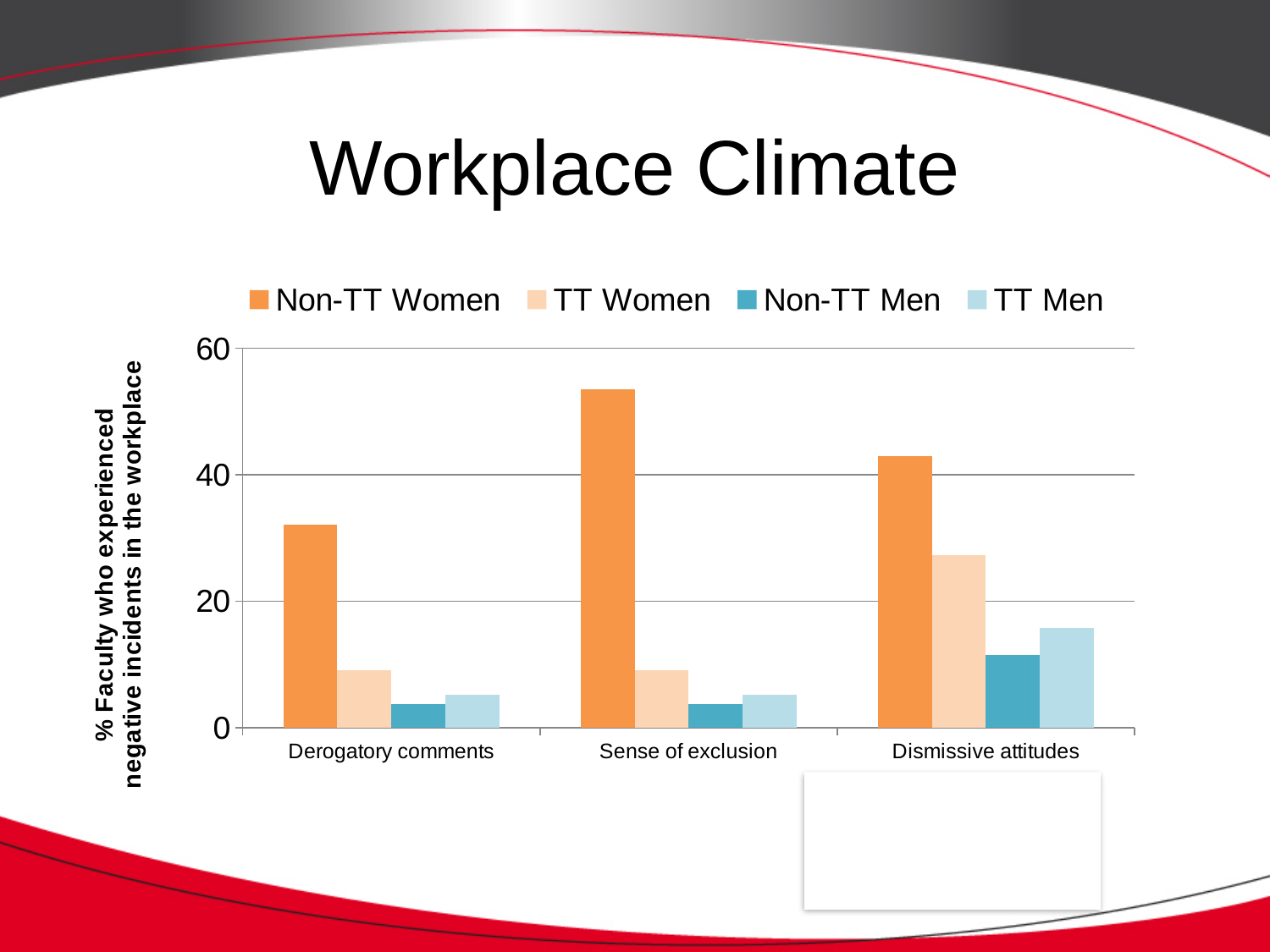
Which category has the highest value for Non-TT Women? Sense of exclusion How many categories are shown on the x axis? 3 Which category has the highest value for TT Women? Dismissive attitudes Is the value for Non-TT Women in Sense of exclusion greater or less than 40? greater Which series has the lowest value in Sense of exclusion? Non-TT Men How many series does the legend list? 4 Is the value for TT Women in Derogatory comments greater or less than 20? less Which is larger in Dismissive attitudes: the value for Non-TT Men or TT Men? TT Men Is the value for TT Women in Dismissive attitudes greater or less than 20? greater What is the label on the vertical axis? % Faculty who experienced negative incidents in the workplace What kind of chart is shown on the Workplace Climate slide? bar chart